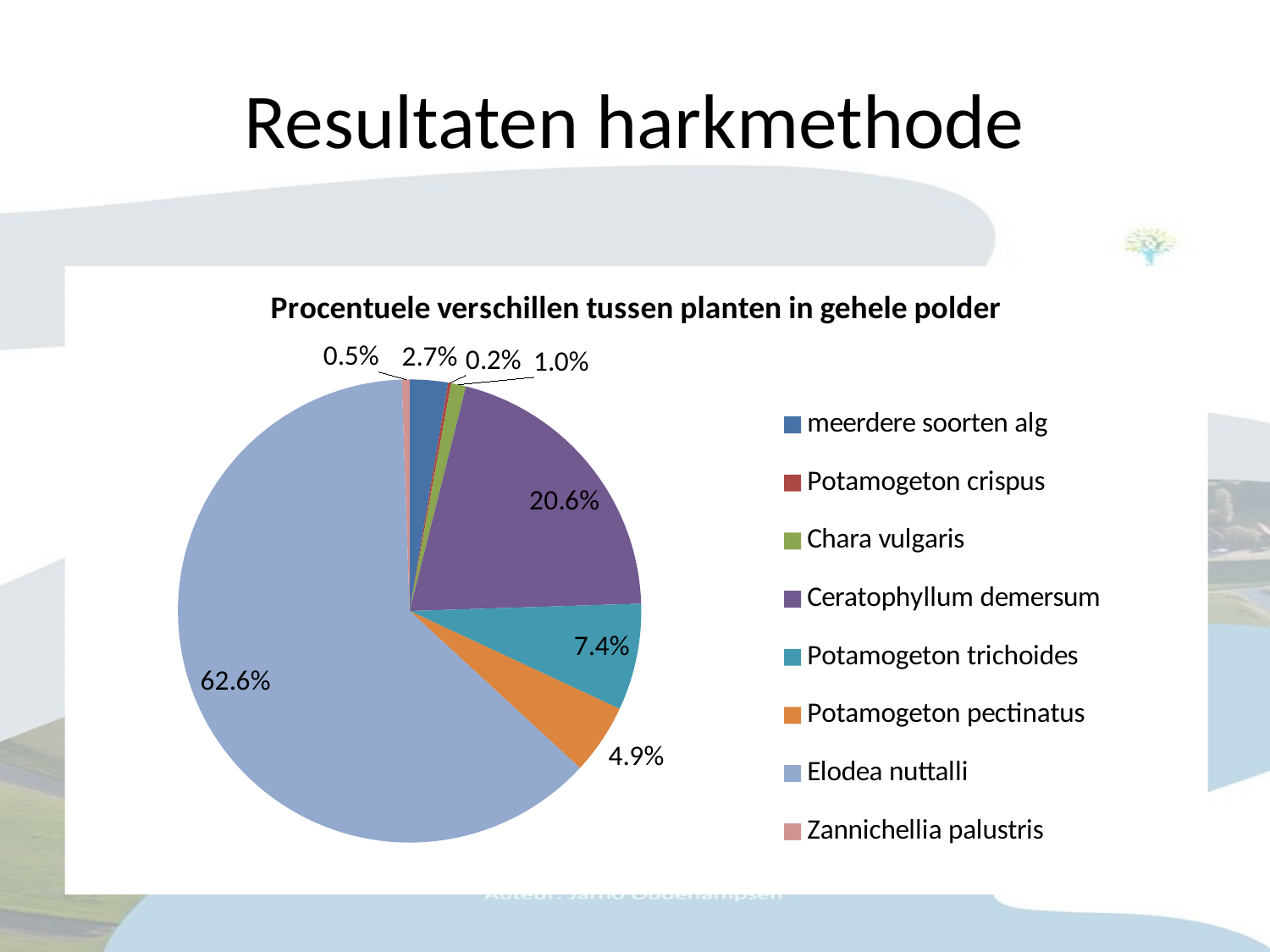
Which category has the smallest slice of the pie? Potamogeton crispus What percentage is shown for meerdere soorten alg? 2.7% What type of chart is shown on the slide? pie chart What is the title of the chart? Procentuele verschillen tussen planten in gehele polder Which has a larger share, Potamogeton pectinatus or Chara vulgaris? Potamogeton pectinatus Which category has the largest slice of the pie? Elodea nuttalli What percentage share does Elodea nuttalli have in the pie chart? 62.6% What percentage is shown for Ceratophyllum demersum? 20.6% What is the difference in percentage points between Ceratophyllum demersum and Potamogeton trichoides? 13.2 What percentage is shown for Potamogeton trichoides? 7.4% How many categories does the legend list? 8 What percentage is shown for Potamogeton pectinatus? 4.9%